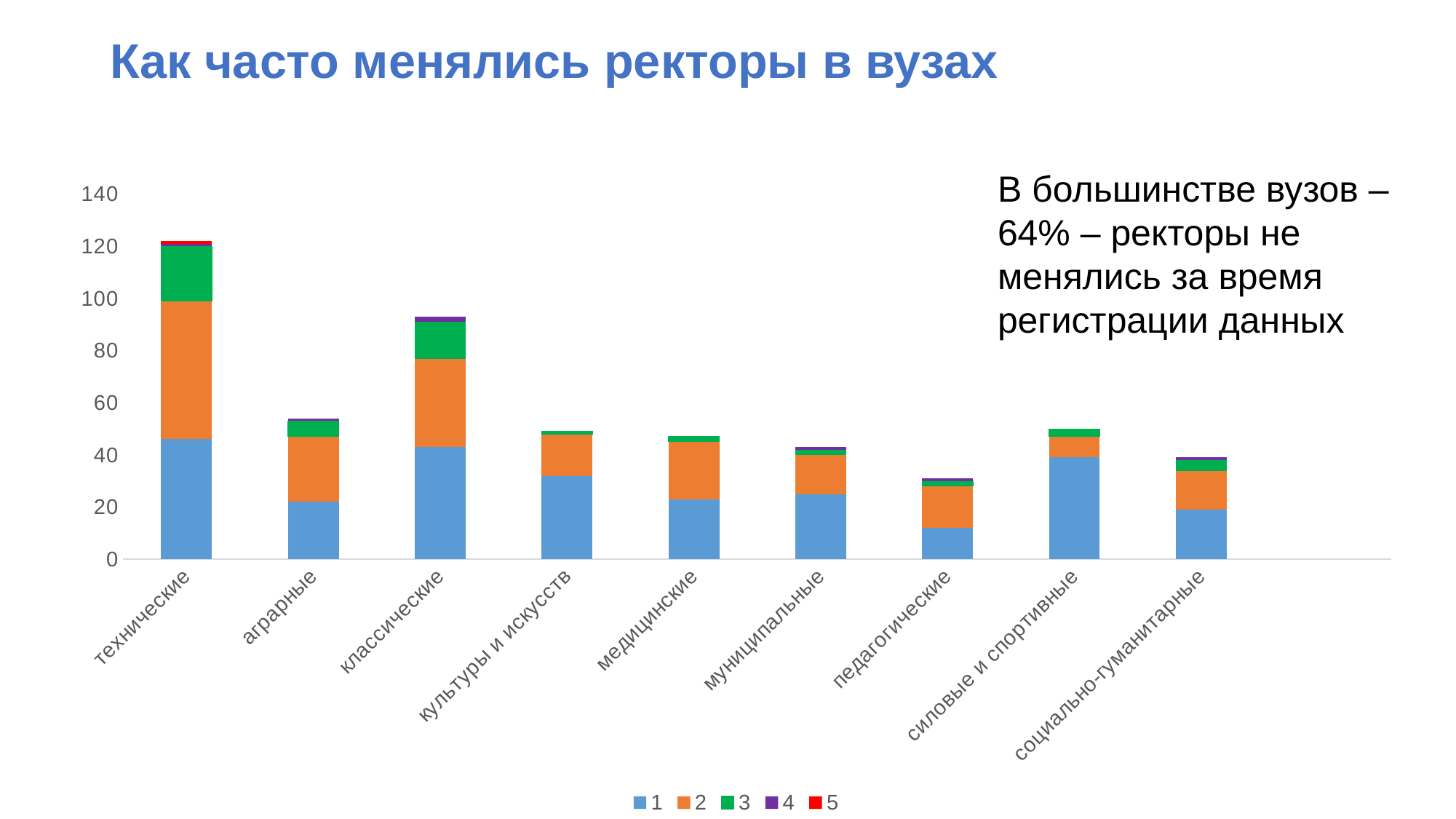
What is the title of the slide? Как часто менялись ректоры в вузах Which has a taller stacked bar, медицинские or педагогические? медицинские Is the total value for классические greater or less than 100? less Which category has the shortest stacked bar? педагогические Which category has the tallest stacked bar? технические Which has a taller stacked bar, технические or классические? технические How many series does the legend list? 5 What kind of chart is shown on the slide? stacked bar chart Is the total value for педагогические greater or less than 40? less Is the total value for силовые и спортивные greater or less than 40? greater How many categories of universities are shown on the x axis? 9